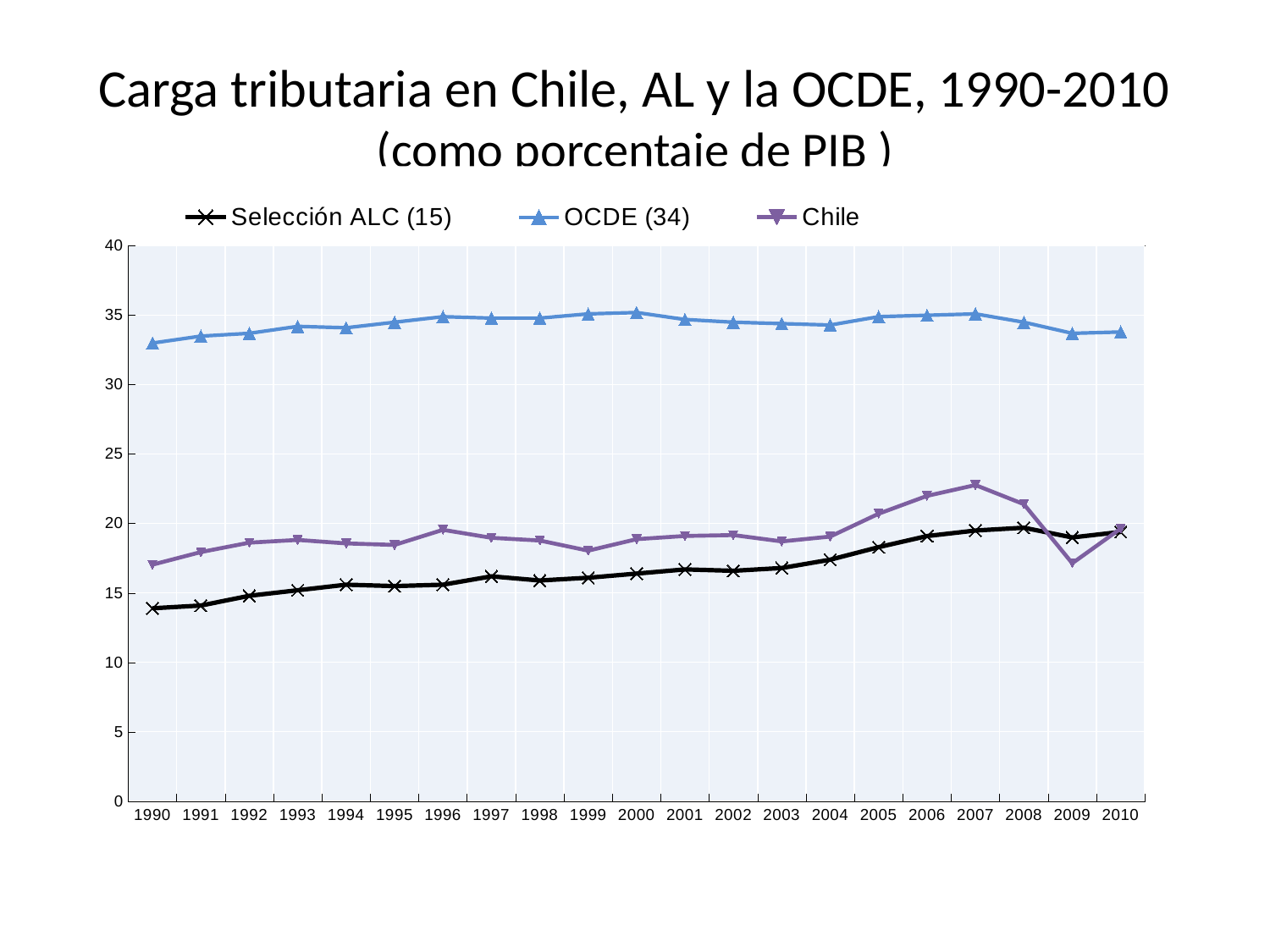
Is the value for Selección ALC (15) in 1990 greater or less than 15? less In which year is the Selección ALC (15) series at its lowest value? 1990 Is the value for OCDE (34) in 1990 greater or less than 30? greater In 2009, which is larger: Selección ALC (15) or Chile? Selección ALC (15) Which series has the highest values throughout the whole period? OCDE (34) How many years are plotted along the x axis? 21 In which year does the Chile series reach its highest value? 2007 Is the value for Chile in 2007 greater or less than 20? greater Does the Selección ALC (15) series generally rise or fall from 1990 to 2008? rise How many series does the legend list? 3 What kind of chart is shown on the slide? line chart